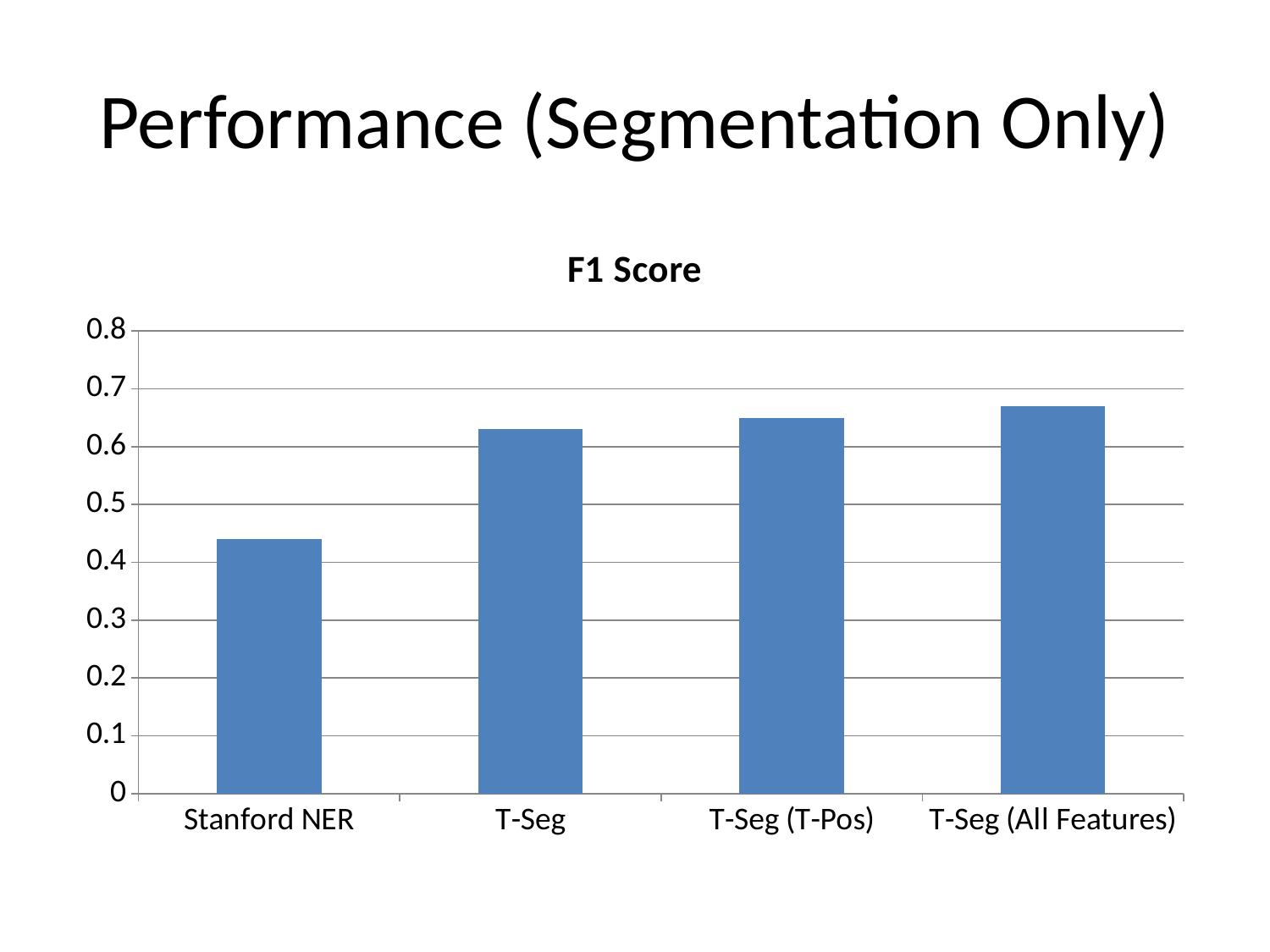
What kind of chart is shown on the slide? bar chart Which category has the lowest F1 Score? Stanford NER Is the F1 Score for T-Seg (All Features) greater or less than 0.7? less Is the F1 Score for Stanford NER greater or less than 0.5? less How many categories are plotted in the F1 Score chart? 4 What is the title of the chart? F1 Score Which has a higher F1 Score, Stanford NER or T-Seg? T-Seg Do the F1 Score values rise or fall from left to right across the categories? rise Is the F1 Score for Stanford NER greater or less than 0.4? greater Which has a higher F1 Score, T-Seg or T-Seg (All Features)? T-Seg (All Features) Which category has the highest F1 Score? T-Seg (All Features)